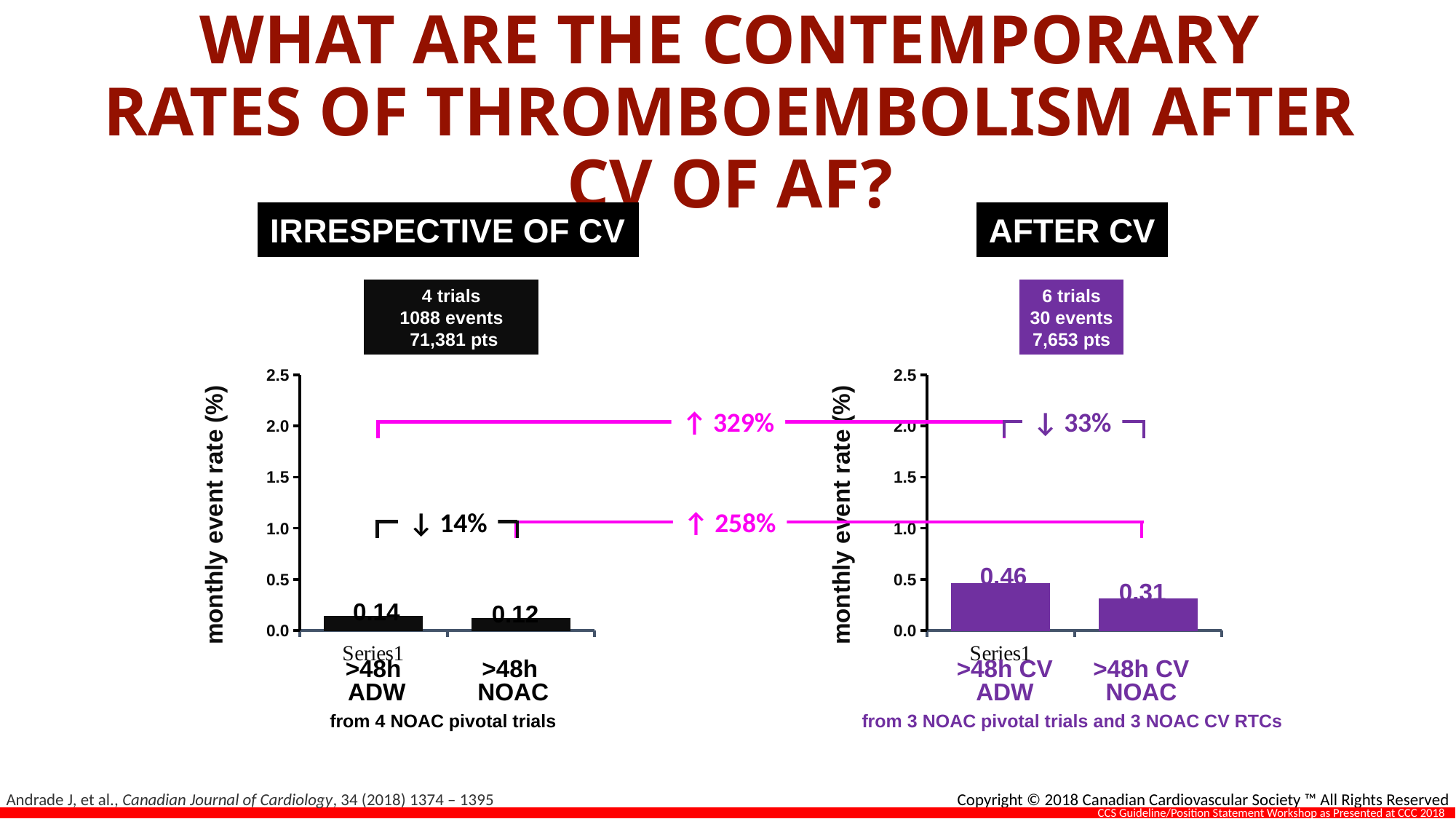
In the AFTER CV chart, what is the difference between the monthly event rates for >48h CV ADW and >48h CV NOAC? 0.15 In the IRRESPECTIVE OF CV chart, which category has the lower monthly event rate? >48h NOAC What is the y-axis label of the AFTER CV chart? monthly event rate (%) In the IRRESPECTIVE OF CV chart, what is the monthly event rate for >48h ADW? 0.14 How many bars are plotted in the AFTER CV chart? 2 In the IRRESPECTIVE OF CV chart, what is the monthly event rate for >48h NOAC? 0.12 In the AFTER CV chart, what is the monthly event rate for >48h CV NOAC? 0.31 In the AFTER CV chart, which category has the higher monthly event rate? >48h CV ADW Is the monthly event rate for >48h CV ADW in the AFTER CV chart greater or less than 0.5? less In the IRRESPECTIVE OF CV chart, what is the difference between the monthly event rates for >48h ADW and >48h NOAC? 0.02 What type of chart is the IRRESPECTIVE OF CV chart? bar chart In the AFTER CV chart, what is the monthly event rate for >48h CV ADW? 0.46